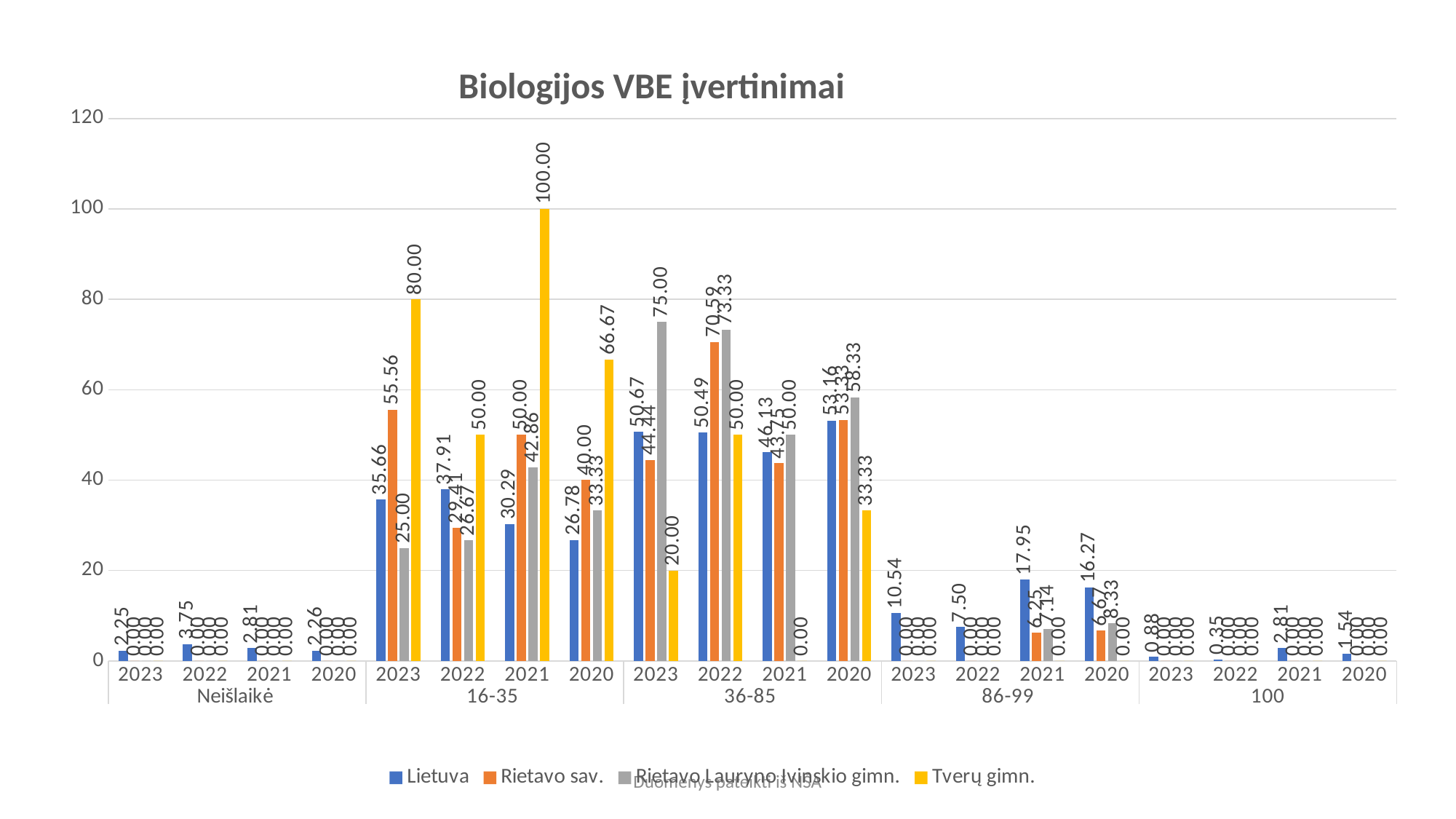
What is the difference between Tverų gimn. and Lietuva in the 16-35 group for 2020? 39.89 What is the title of the chart? Biologijos VBE įvertinimai Is the value for Rietavo sav. in the 16-35 group for 2023 greater or less than 40? greater How many series does the legend list? 4 In the 36-85 group for 2022, which is larger: Rietavo sav. or Lietuva? Rietavo sav. What is the value for Rietavo Lauryno Ivinskio gimn. in the 36-85 group for 2023? 75.00 Which series has the highest value in the 16-35 group for 2023? Tverų gimn. Which series has the lowest value in the 36-85 group for 2023? Tverų gimn. What kind of chart is shown on the slide? Bar chart What is the value for Lietuva in the 16-35 group for 2023? 35.66 What is the value for Lietuva in the 86-99 group for 2021? 17.95 What is the value for Tverų gimn. in the 16-35 group for 2021? 100.00